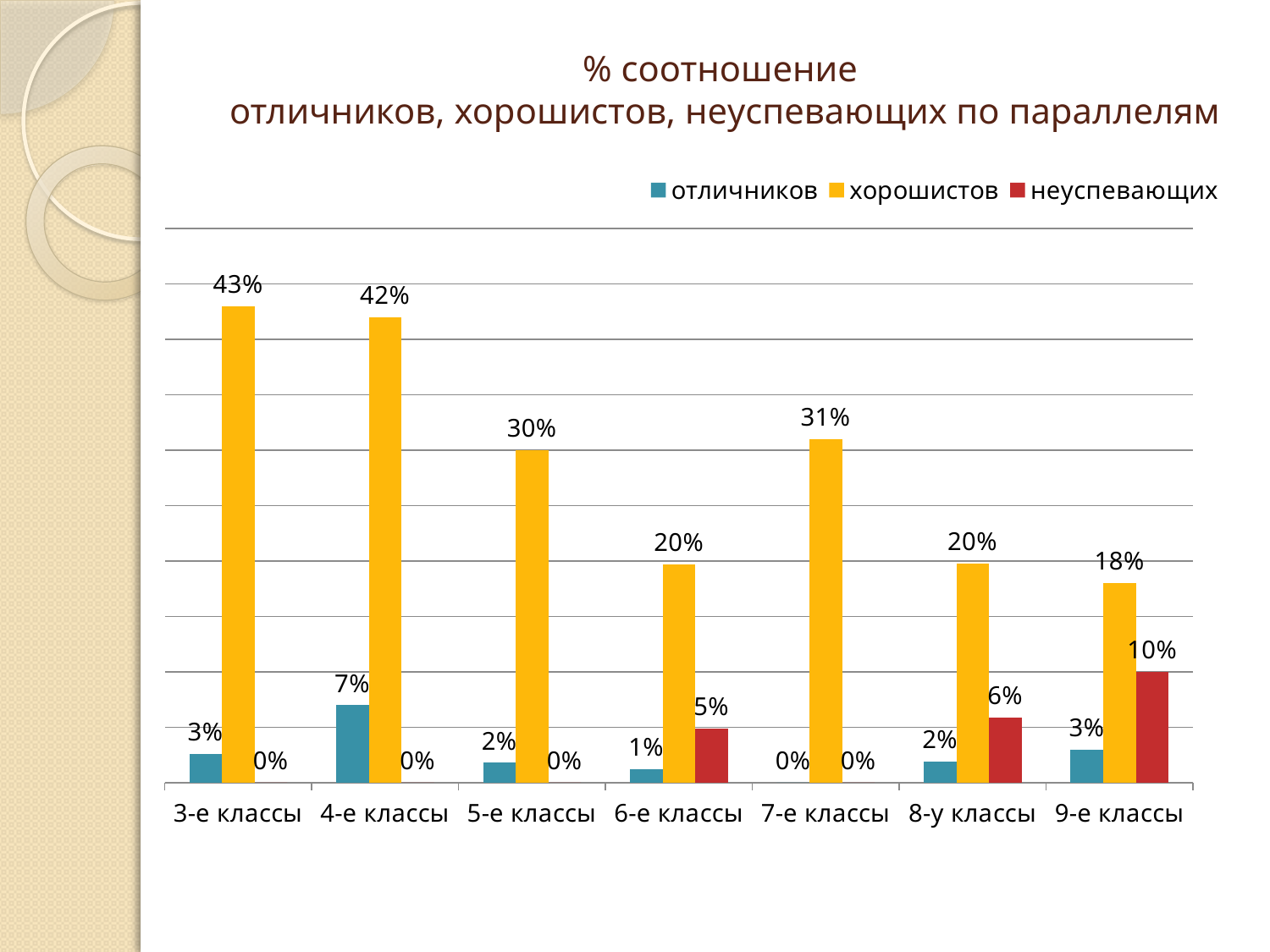
What is the value for неуспевающих in 9-е классы? 10% What is the difference between хорошистов in 5-е классы and 6-е классы? 10% What is the value for хорошистов in 3-е классы? 43% Which series is shown in red? неуспевающих How many categories are shown on the x axis? 7 Which category has the highest value for хорошистов? 3-е классы What kind of chart is shown on the slide? bar chart How many series does the legend list? 3 What is the value for хорошистов in 7-е классы? 31% What is the value for отличников in 4-е классы? 7% Which is larger: неуспевающих in 6-е классы or in 8-у классы? 8-у классы Which category has the lowest value for хорошистов? 9-е классы